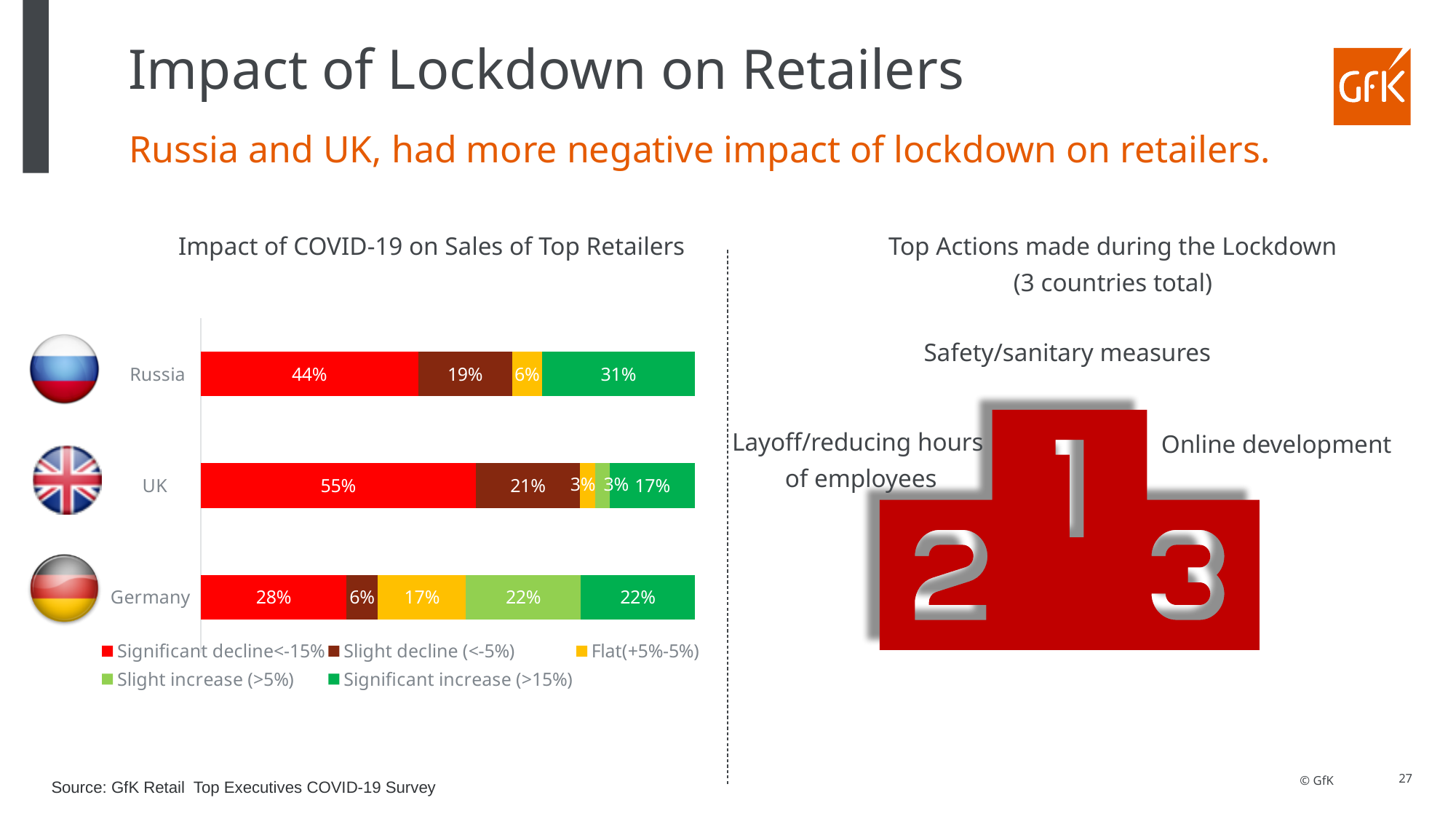
What is the Flat(+5%-5%) value for Russia? 6% What is the Slight increase (>5%) value for Germany? 22% Which country has the lowest Significant decline (<-15%) value? Germany Which colour represents Significant increase (>15%) in the chart? Green Which country has the highest Significant decline (<-15%) value? UK How many countries are shown in the "Impact of COVID-19 on Sales of Top Retailers" chart? 3 Which is larger: the Slight decline (<-5%) value for Russia or for Germany? Russia What is the Significant increase (>15%) value for Russia? 31% What is the Significant decline (<-15%) value for the UK? 55% What type of chart is "Impact of COVID-19 on Sales of Top Retailers"? Stacked bar chart How many series does the legend of the "Impact of COVID-19 on Sales of Top Retailers" chart list? 5 What is the difference between the Significant decline (<-15%) values for the UK and Russia? 11%